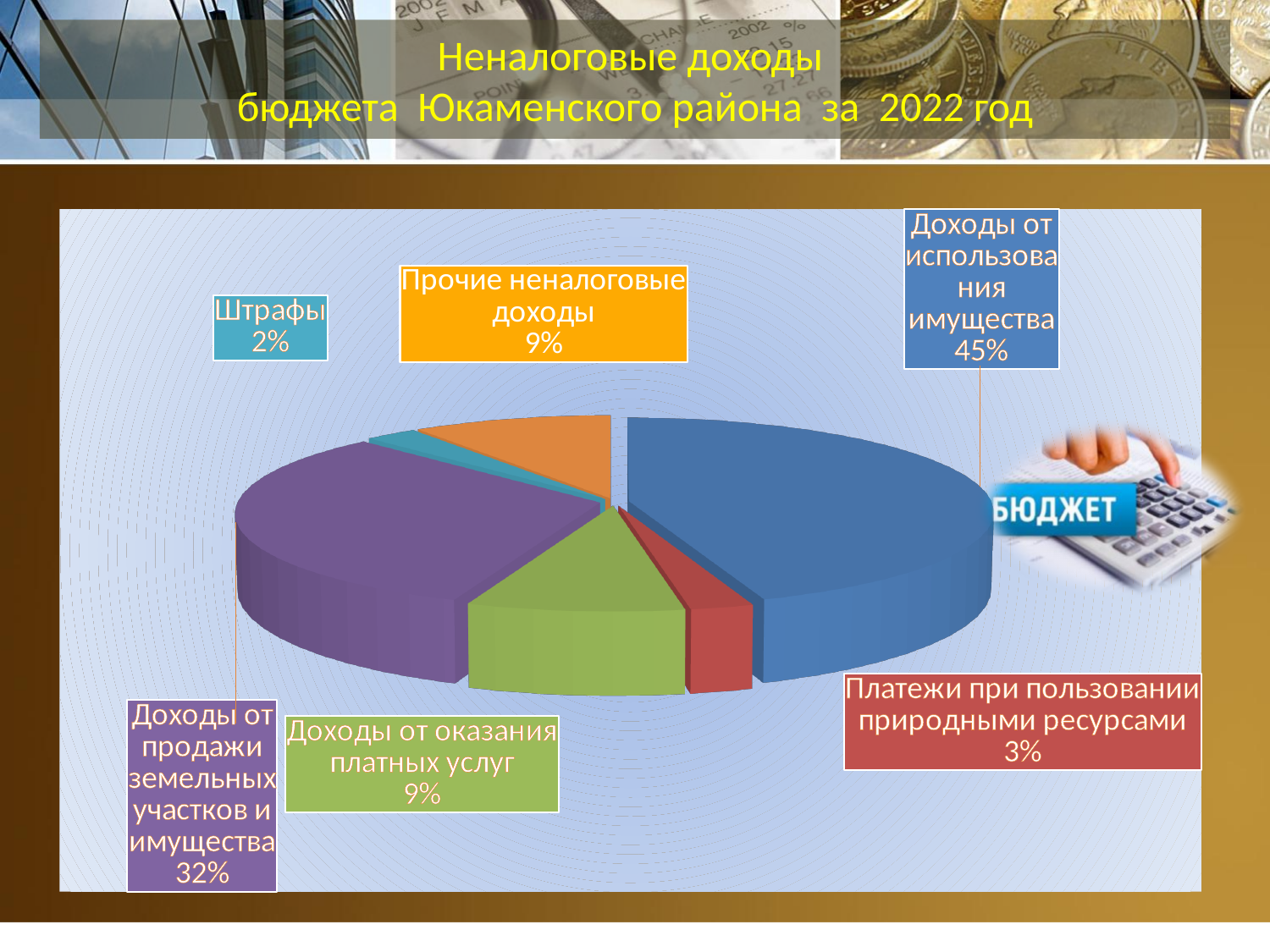
Which category has the smallest share of the pie? Штрафы How many slices does the pie chart have? 6 What kind of chart is shown on the slide? pie chart What share is shown for "Доходы от продажи земельных участков и имущества"? 32% What share is shown for "Прочие неналоговые доходы"? 9% What is the title of the slide containing the chart? Неналоговые доходы бюджета Юкаменского района за 2022 год What percentage is shown for "Штрафы"? 2% What is the difference in percentage points between "Доходы от использования имущества" and "Доходы от продажи земельных участков и имущества"? 13 Which is larger: the share for "Платежи при пользовании природными ресурсами" or the share for "Доходы от оказания платных услуг"? Доходы от оказания платных услуг What share of non-tax revenue comes from "Доходы от использования имущества"? 45% Which category has the largest share of the pie? Доходы от использования имущества What percentage is shown for "Платежи при пользовании природными ресурсами"? 3%